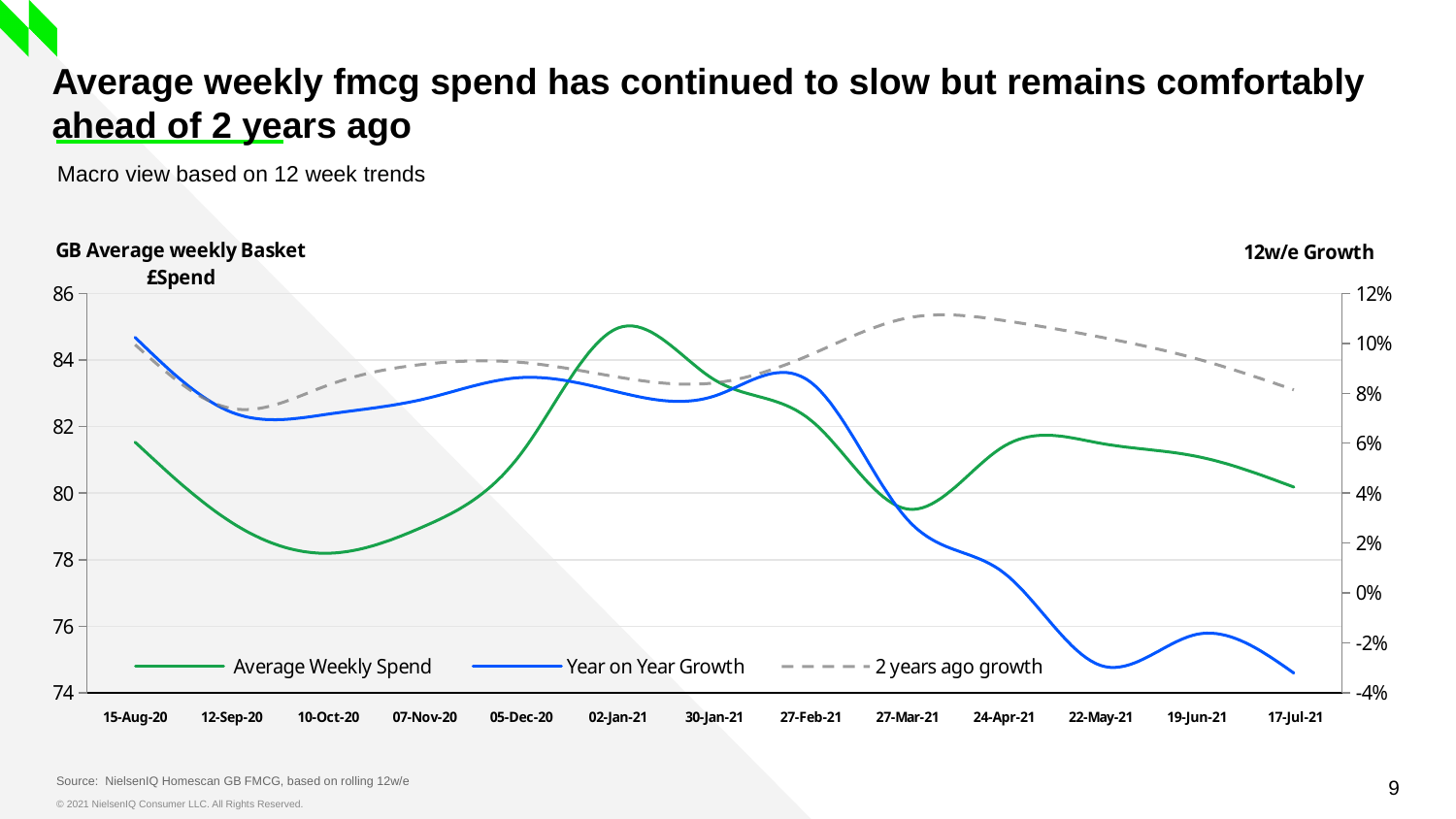
At 17-Jul-21, which is higher: Year on Year Growth or 2 years ago growth? 2 years ago growth Is the Average Weekly Spend value at 02-Jan-21 greater or less than 84? greater Is the Year on Year Growth value at 27-Mar-21 greater or less than 4%? less At which labelled date is Average Weekly Spend at its lowest? 10-Oct-20 How many dates are labelled along the x axis of the chart? 13 Is the Year on Year Growth value at 17-Jul-21 greater or less than 0%? less How many series does the chart legend list? 3 Does Year on Year Growth rise or fall between 27-Feb-21 and 17-Jul-21? Fall What type of chart is shown on the slide? Line chart At which labelled date is Average Weekly Spend at its highest? 02-Jan-21